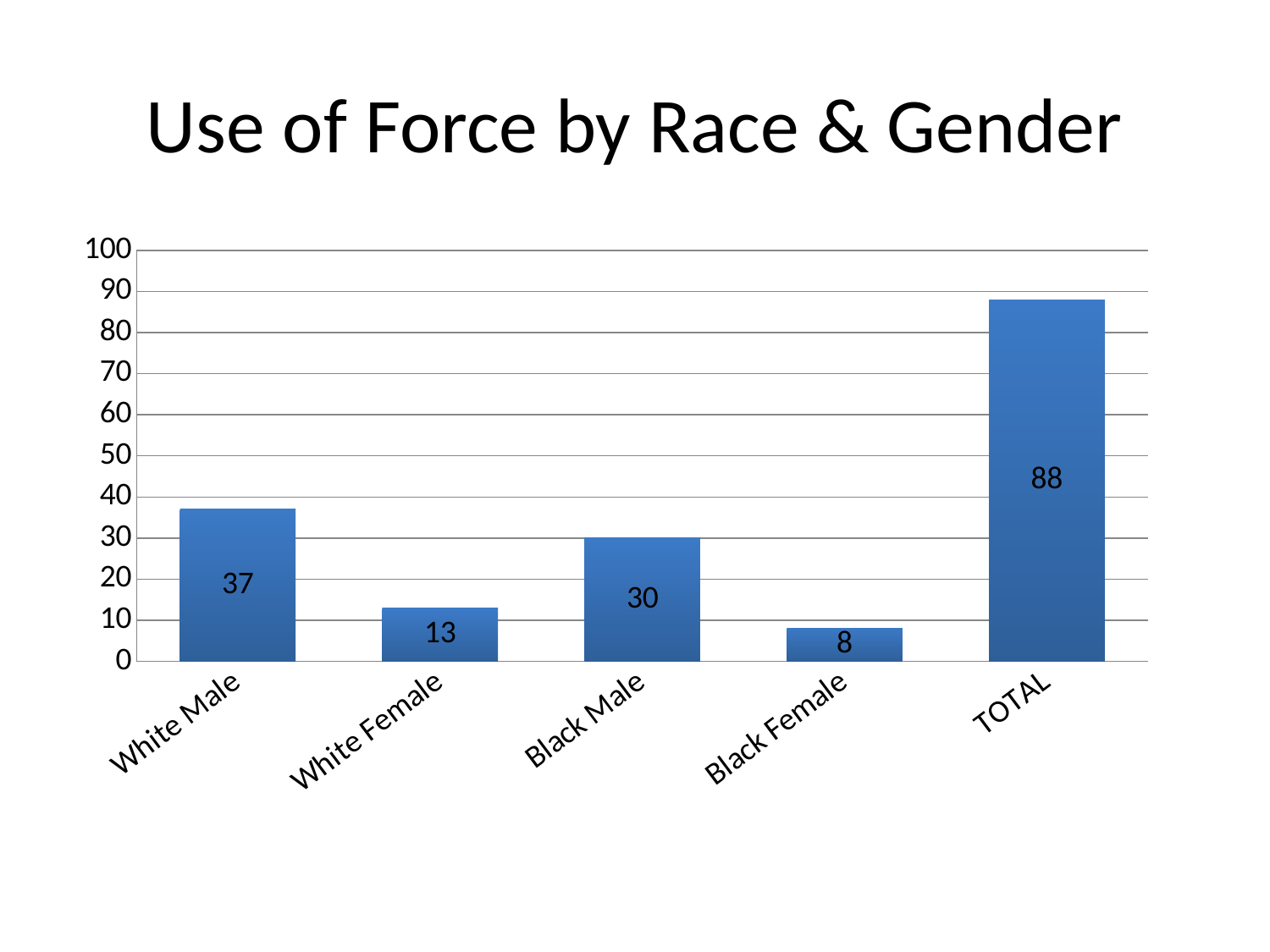
What is the value for TOTAL? 88 What is the difference between the values for White Male and Black Male? 7 What is the value for Black Female? 8 How many categories are shown on the x axis? 5 What is the title of the slide? Use of Force by Race & Gender What kind of chart is shown on the slide? bar chart What is the value for White Female? 13 Which is larger, the value for White Female or the value for Black Female? White Female Which category has the lowest value? Black Female Is the value for Black Male greater or less than 20? greater Which category has the highest value? TOTAL What is the value for White Male? 37